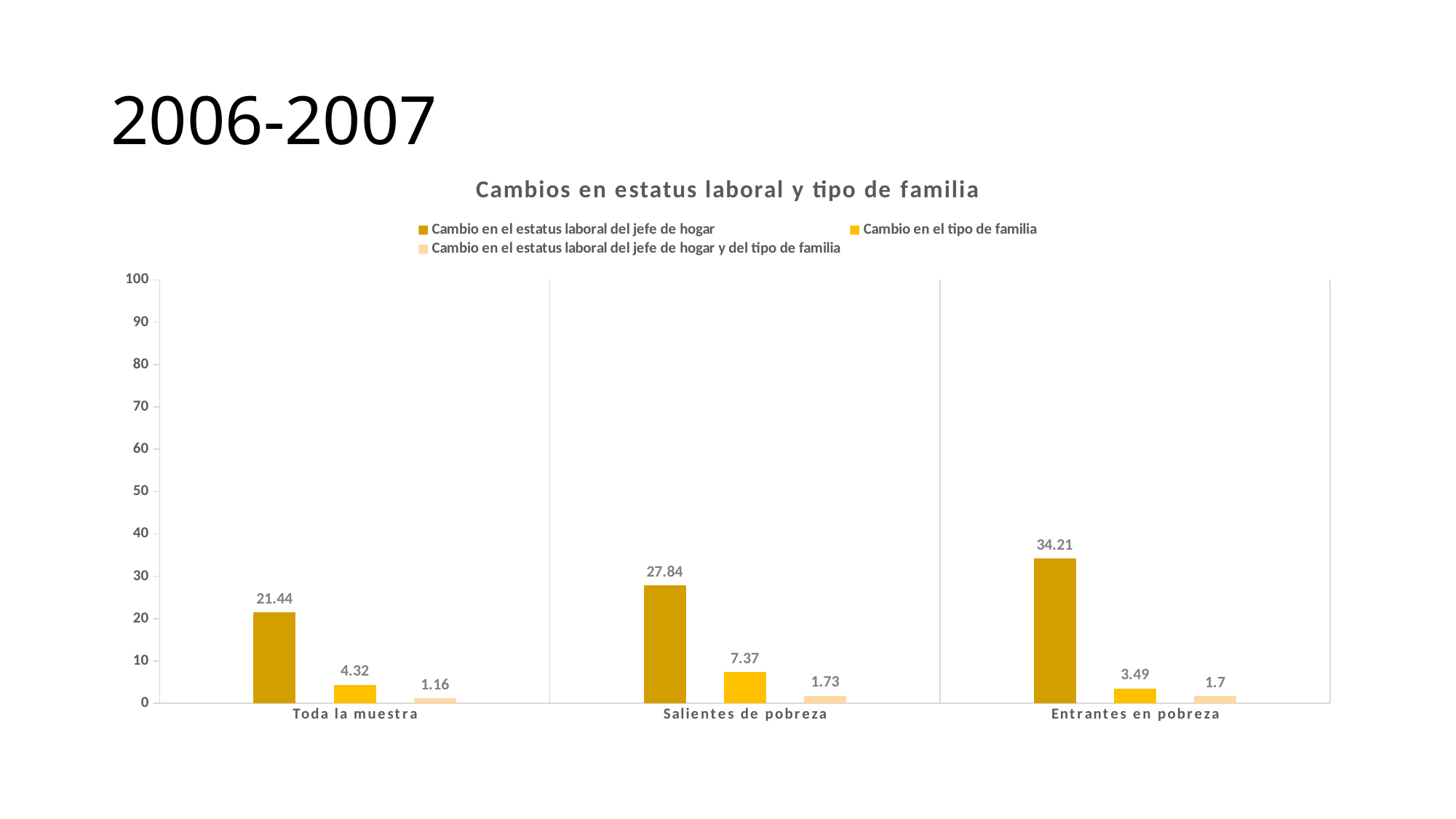
How many categories are shown on the x axis? 3 What kind of chart is shown on the slide? bar chart What is the title of the chart? Cambios en estatus laboral y tipo de familia What is the value of 'Cambio en el estatus laboral del jefe de hogar y del tipo de familia' for 'Entrantes en pobreza'? 1.7 Is the value of 'Cambio en el estatus laboral del jefe de hogar' for 'Salientes de pobreza' greater or less than 30? less What is the difference between the 'Cambio en el estatus laboral del jefe de hogar' values for 'Entrantes en pobreza' and 'Toda la muestra'? 12.77 How many series does the legend list? 3 What is the value of 'Cambio en el tipo de familia' for 'Salientes de pobreza'? 7.37 Which category has the highest value for 'Cambio en el estatus laboral del jefe de hogar'? Entrantes en pobreza What is the value of 'Cambio en el estatus laboral del jefe de hogar' for 'Toda la muestra'? 21.44 Which is larger: 'Cambio en el tipo de familia' for 'Toda la muestra' or for 'Salientes de pobreza'? Salientes de pobreza Which category has the lowest value for 'Cambio en el tipo de familia'? Entrantes en pobreza